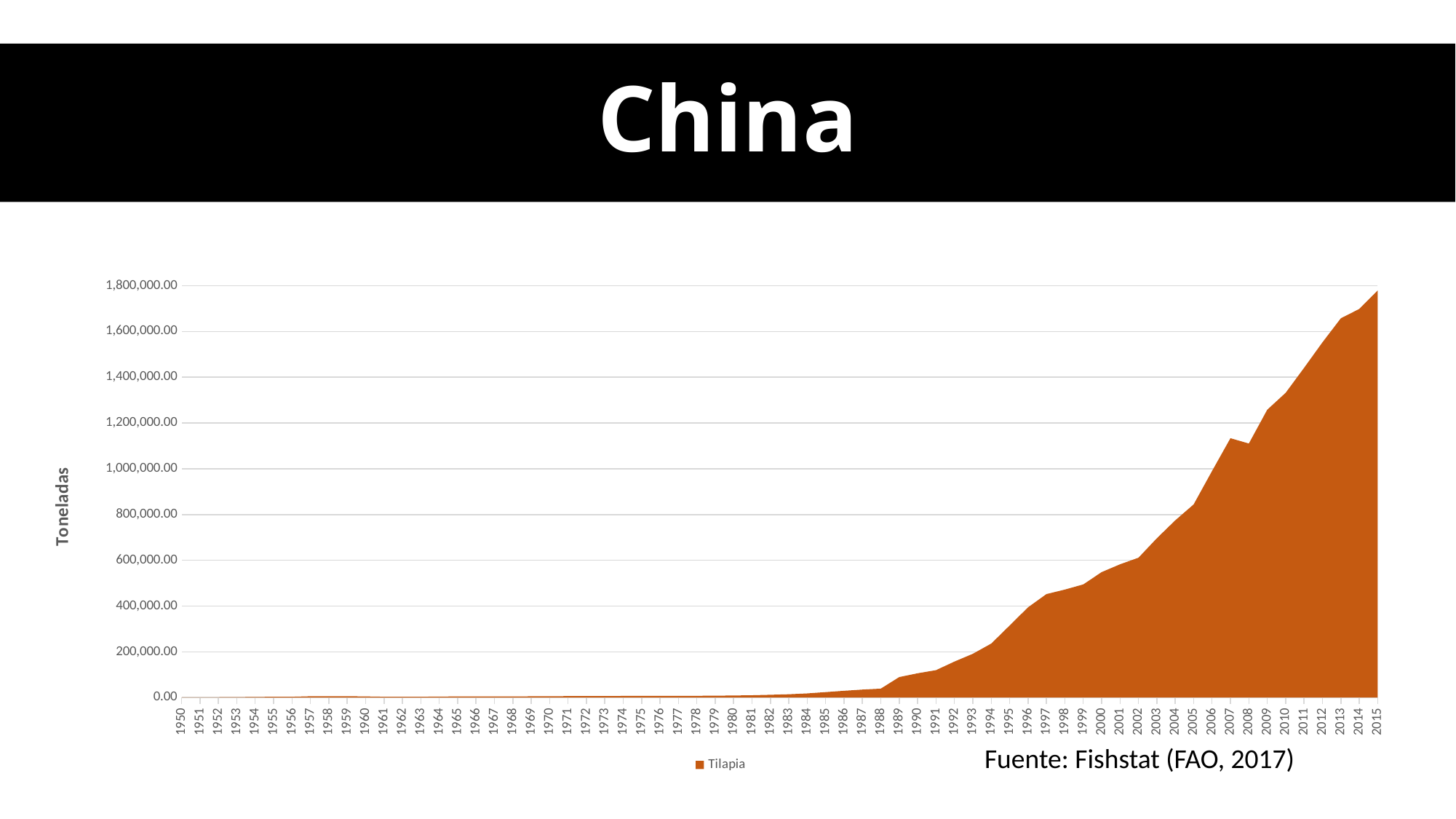
Is the value for 1990 greater or less than 200,000.00? less What is the label on the vertical axis? Toneladas Is the value for 2015 greater or less than 1,600,000.00? greater Which year has the larger Tilapia value, 2000 or 2015? 2015 Is the value for 2006 greater or less than 800,000.00? greater Do the values generally rise or fall from 1950 to 2015? Rise In which year is the Tilapia value highest? 2015 How many series does the legend list? 1 What is the name of the series shown in the legend? Tilapia What kind of chart is shown on the slide? Area chart